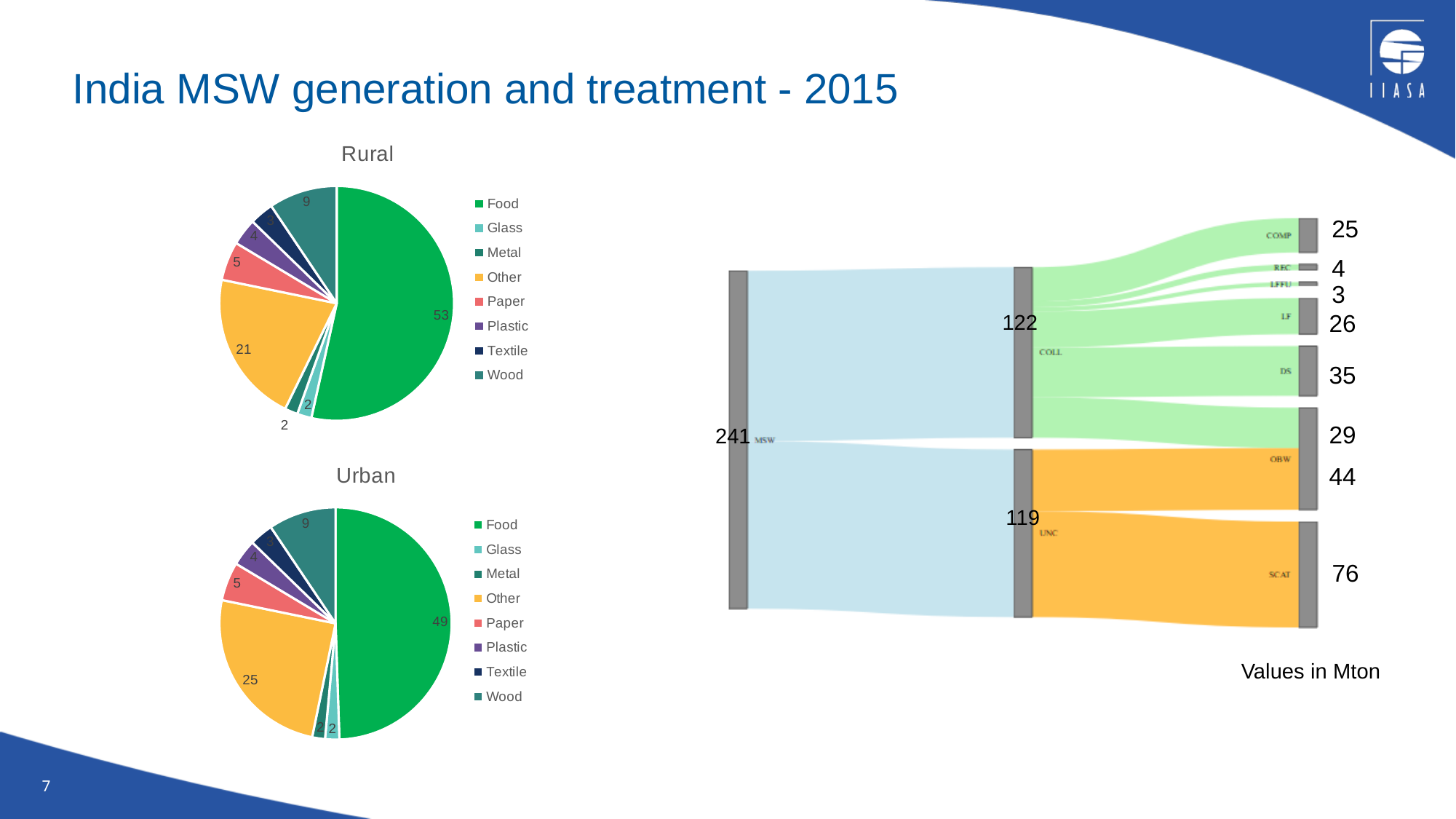
Is the Food value larger in the Rural pie chart or the Urban pie chart? Rural In the Rural pie chart, which category has the largest slice? Food In the Urban pie chart, what is the value shown for Other? 25 In the flow diagram on the right, what is the value shown for MSW? 241 In the Urban pie chart, what is the value shown for Wood? 9 In the flow diagram on the right, what is the value shown for SCAT? 76 In the flow diagram on the right, what is the difference between the COLL value (122) and the UNC value (119)? 3 How many categories does the legend of the Rural pie chart list? 8 What is the difference between the Other value in the Urban pie chart and the Other value in the Rural pie chart? 4 What kind of chart is the Rural chart? Pie chart In the Rural pie chart, what is the value shown for Food? 53 In what units are the values in the flow diagram on the right given? Mton